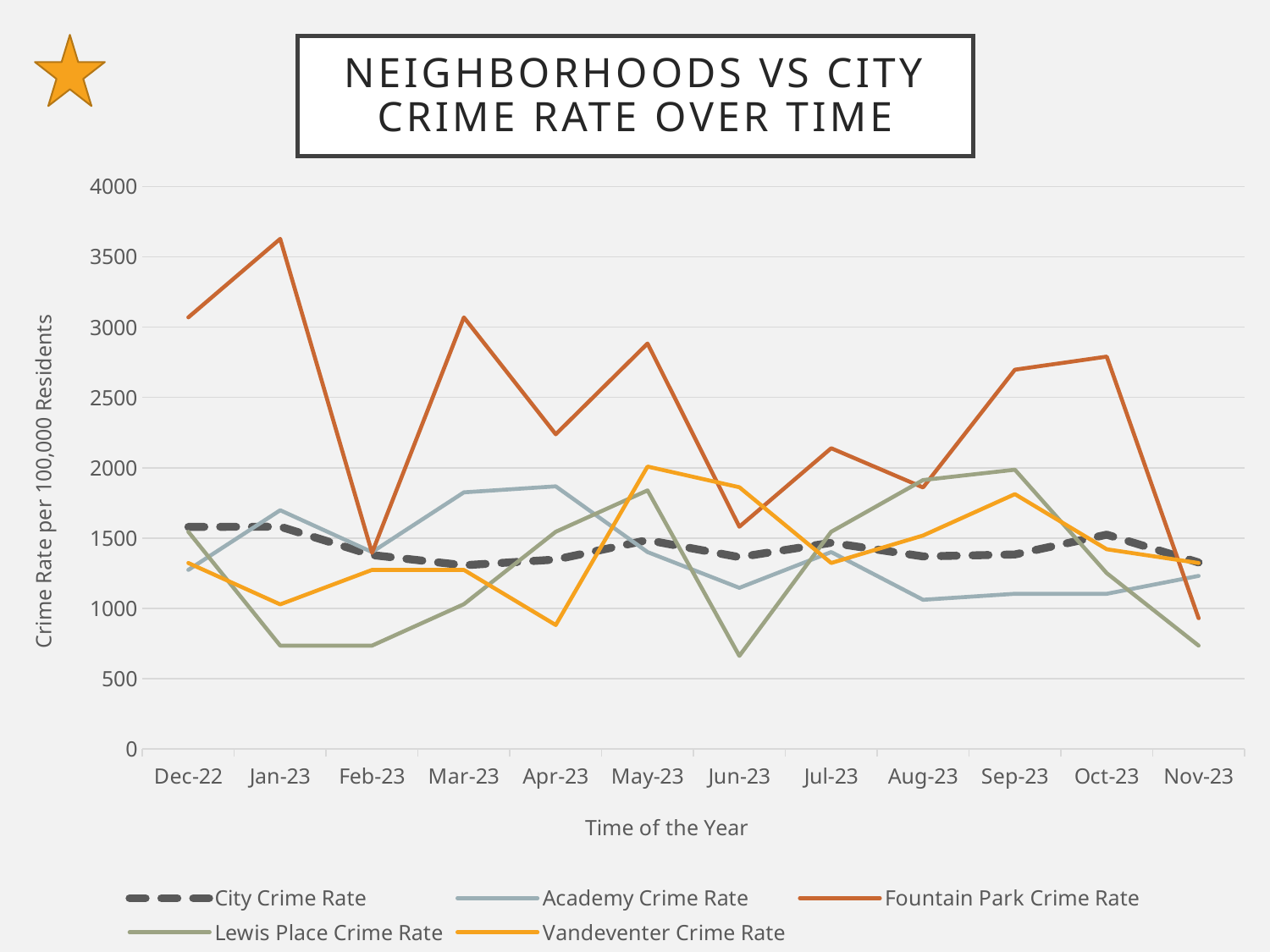
What is the title of the y axis? Crime Rate per 100,000 Residents Does the Lewis Place Crime Rate rise or fall from Sep-23 to Nov-23? Fall In which month does the Fountain Park Crime Rate reach its highest value? Jan-23 In Sep-23, which is higher: the Lewis Place Crime Rate or the Academy Crime Rate? Lewis Place Crime Rate In Dec-22, which is higher: the Fountain Park Crime Rate or the Academy Crime Rate? Fountain Park Crime Rate In which month does the Fountain Park Crime Rate reach its lowest value? Nov-23 How many series does the legend list? 5 Is the Vandeventer Crime Rate in May-23 greater or less than 1500? greater What kind of chart is shown on the slide? Line chart How many months are plotted along the x axis? 12 Is the Lewis Place Crime Rate in Jun-23 greater or less than 1000? less Is the Fountain Park Crime Rate in Jan-23 greater or less than 3500? greater